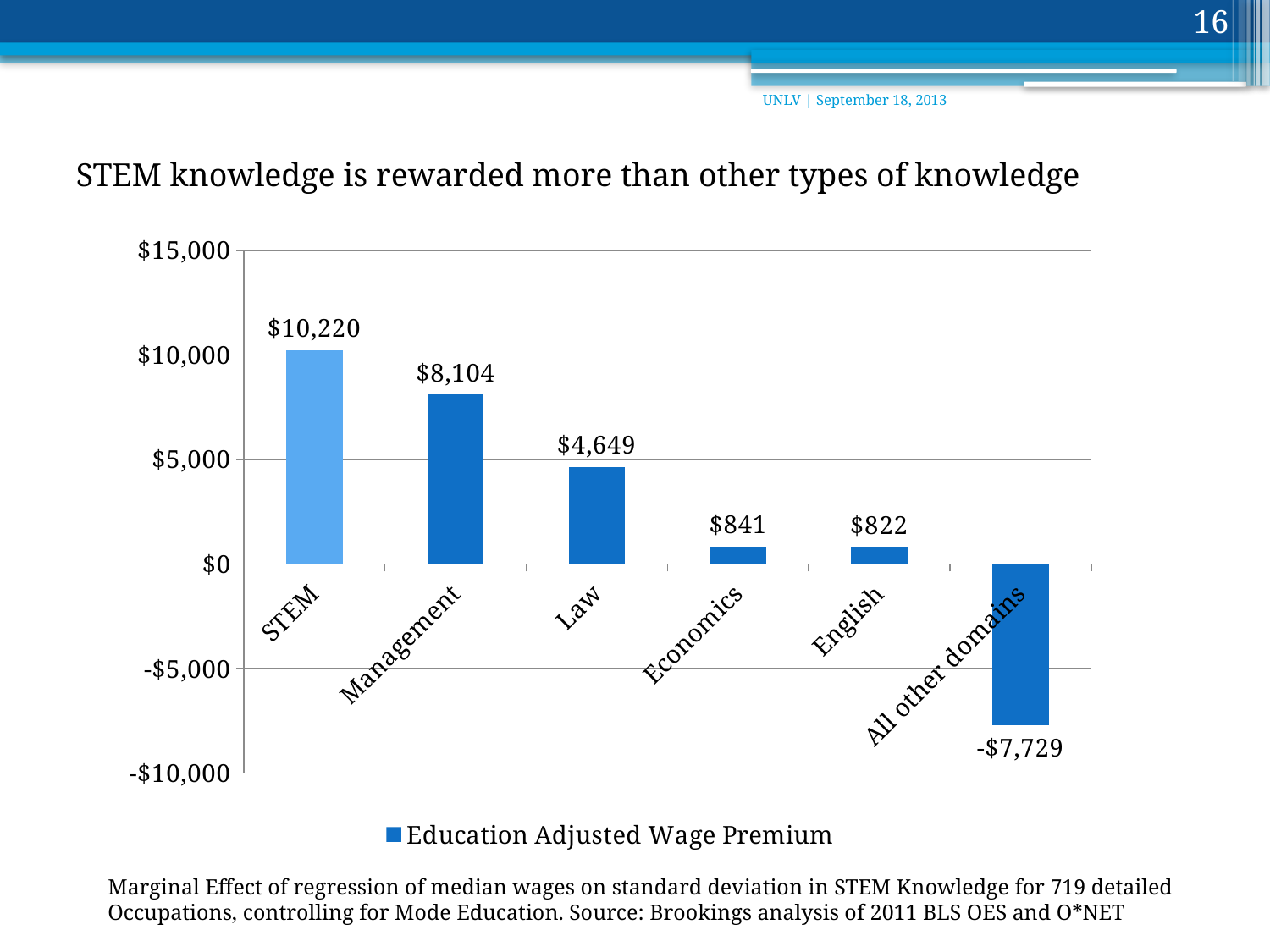
What is the Education Adjusted Wage Premium for Management? $8,104 Which category has the lowest Education Adjusted Wage Premium? All other domains How many categories are shown on the x axis? 6 What kind of chart is shown on the slide? Bar chart Which category has the highest Education Adjusted Wage Premium? STEM What is the Education Adjusted Wage Premium for All other domains? -$7,729 What is the difference between the wage premium for STEM and for Management? $2,116 Which has a larger Education Adjusted Wage Premium, Law or Management? Management How many series does the legend list? 1 What is the difference between the wage premium for Economics and for English? $19 Is the value for Law greater or less than $5,000? less What is the Education Adjusted Wage Premium for STEM? $10,220